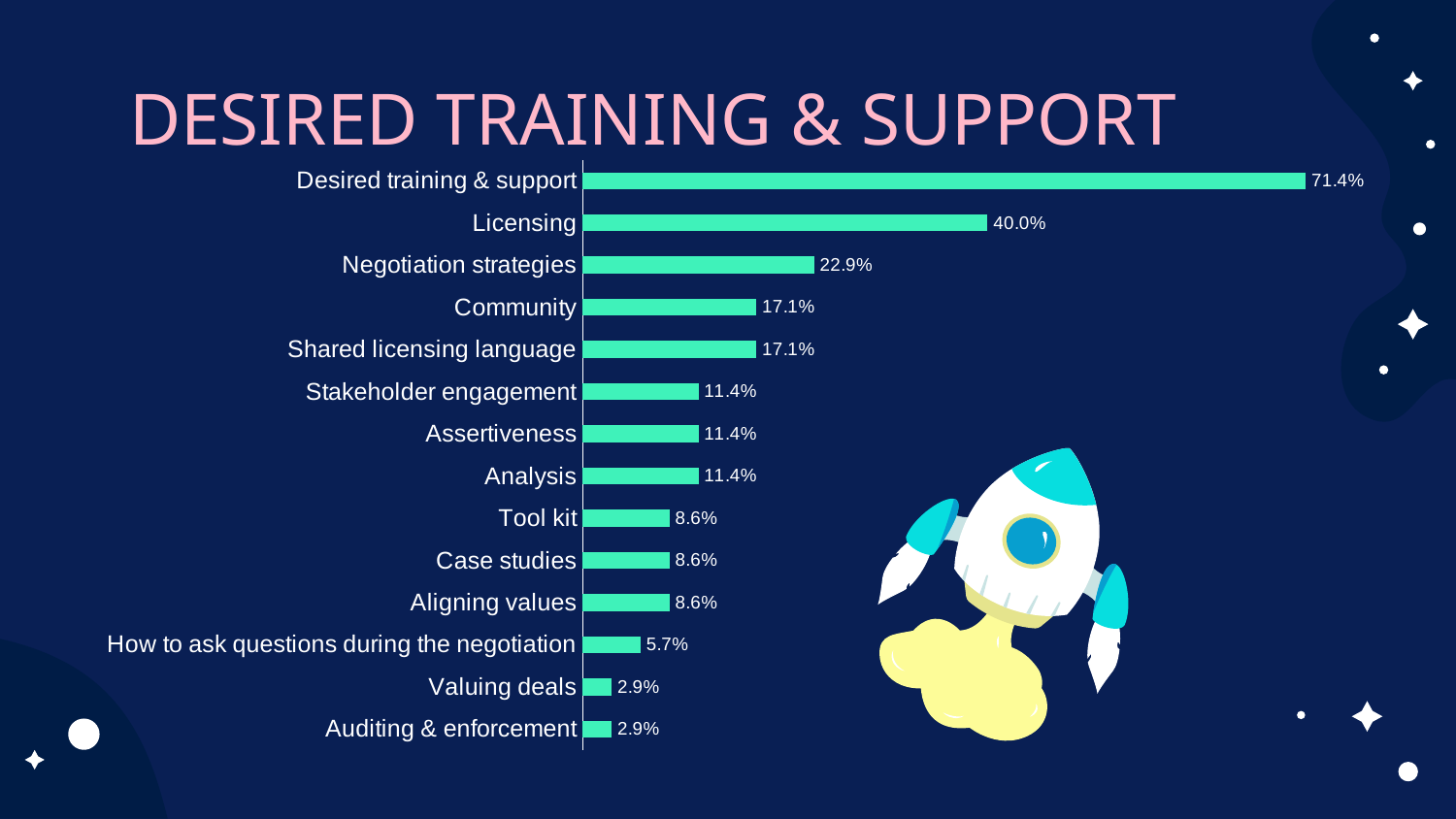
Which is larger, the value for Community or the value for Stakeholder engagement? Community What type of chart is shown on the slide? Bar chart Which category has the highest value? Desired training & support What is the value for Tool kit? 8.6% What is the value for Shared licensing language? 17.1% Which two categories share the lowest value? Valuing deals and Auditing & enforcement What is the value for Licensing? 40.0% What is the value for Negotiation strategies? 22.9% What is the value for How to ask questions during the negotiation? 5.7% What is the title of the slide? DESIRED TRAINING & SUPPORT What is the difference between the values for Desired training & support and Licensing? 31.4% How many categories are shown in the chart? 14